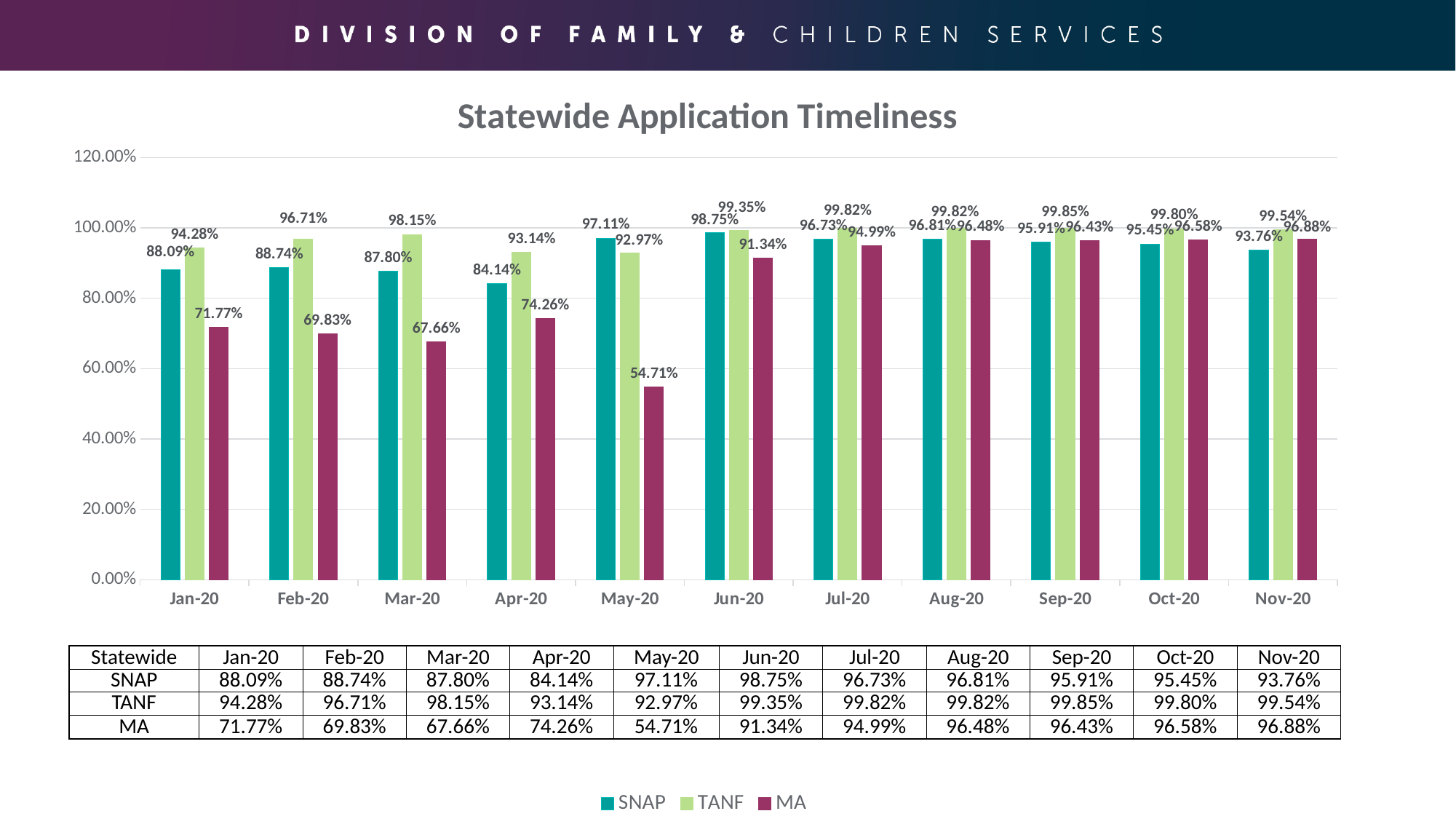
What is the title of the chart? Statewide Application Timeliness What is the SNAP value for May-20? 97.11% What is the MA value for Jun-20? 91.34% How many series does the legend list? 3 What is the difference between the TANF and MA values in May-20? 38.26% What kind of chart is shown on the slide? Bar chart In which month is the SNAP value lowest? Apr-20 In which month is the MA value lowest? May-20 How many months are shown on the x axis? 11 Which is larger in Nov-20, the SNAP value or the MA value? MA In which month is the TANF value highest? Sep-20 What is the TANF value for Mar-20? 98.15%